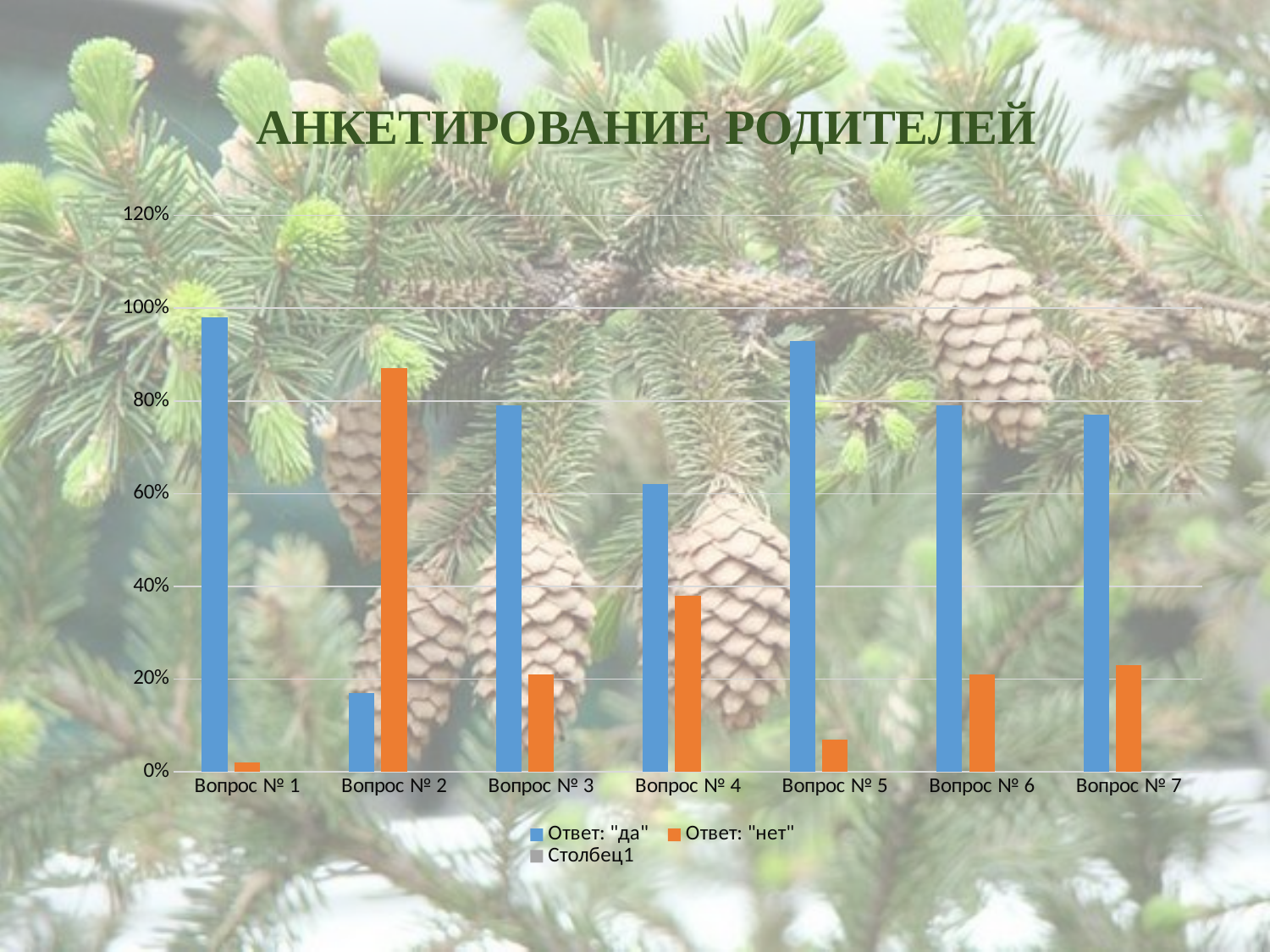
Is the Ответ: "да" value for Вопрос № 1 greater or less than 80%? greater For which question is the Ответ: "нет" bar the lowest? Вопрос № 1 What is the title of the slide? АНКЕТИРОВАНИЕ РОДИТЕЛЕЙ How many questions (categories) are shown on the x axis? 7 How many series does the legend list? 3 Which is larger: the Ответ: "да" value for Вопрос № 4 or for Вопрос № 7? Вопрос № 7 For Вопрос № 2, which is larger: Ответ: "да" or Ответ: "нет"? Ответ: "нет" What kind of chart is shown on the slide? Bar chart For which question is the Ответ: "нет" bar the highest? Вопрос № 2 For which question is the Ответ: "да" bar the lowest? Вопрос № 2 Is the Ответ: "нет" value for Вопрос № 5 greater or less than 20%? less For which question is the Ответ: "да" bar the highest? Вопрос № 1